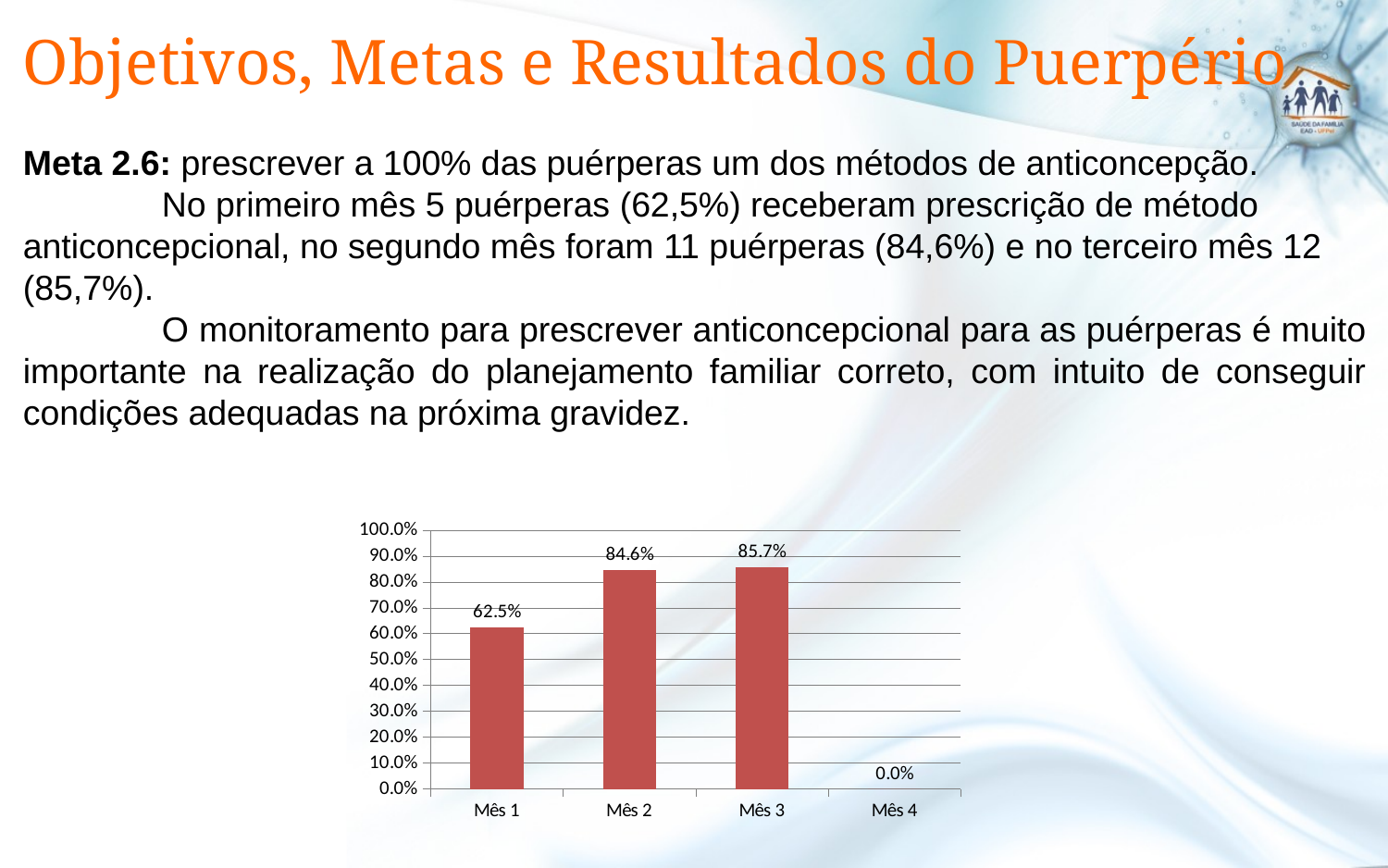
What is the value for Mês 4? 0.0% What is the value for Mês 3? 85.7% What kind of chart is shown on the slide? bar chart What is the value for Mês 1? 62.5% Is the value for Mês 1 greater or less than 70.0%? less Which is larger, the value for Mês 1 or the value for Mês 2? Mês 2 What is the difference between the values for Mês 2 and Mês 1? 22.1% What is the value for Mês 2? 84.6% How many categories are shown on the x axis? 4 Which category has the lowest value? Mês 4 What is the difference between the values for Mês 3 and Mês 2? 1.1% Which category has the highest value? Mês 3